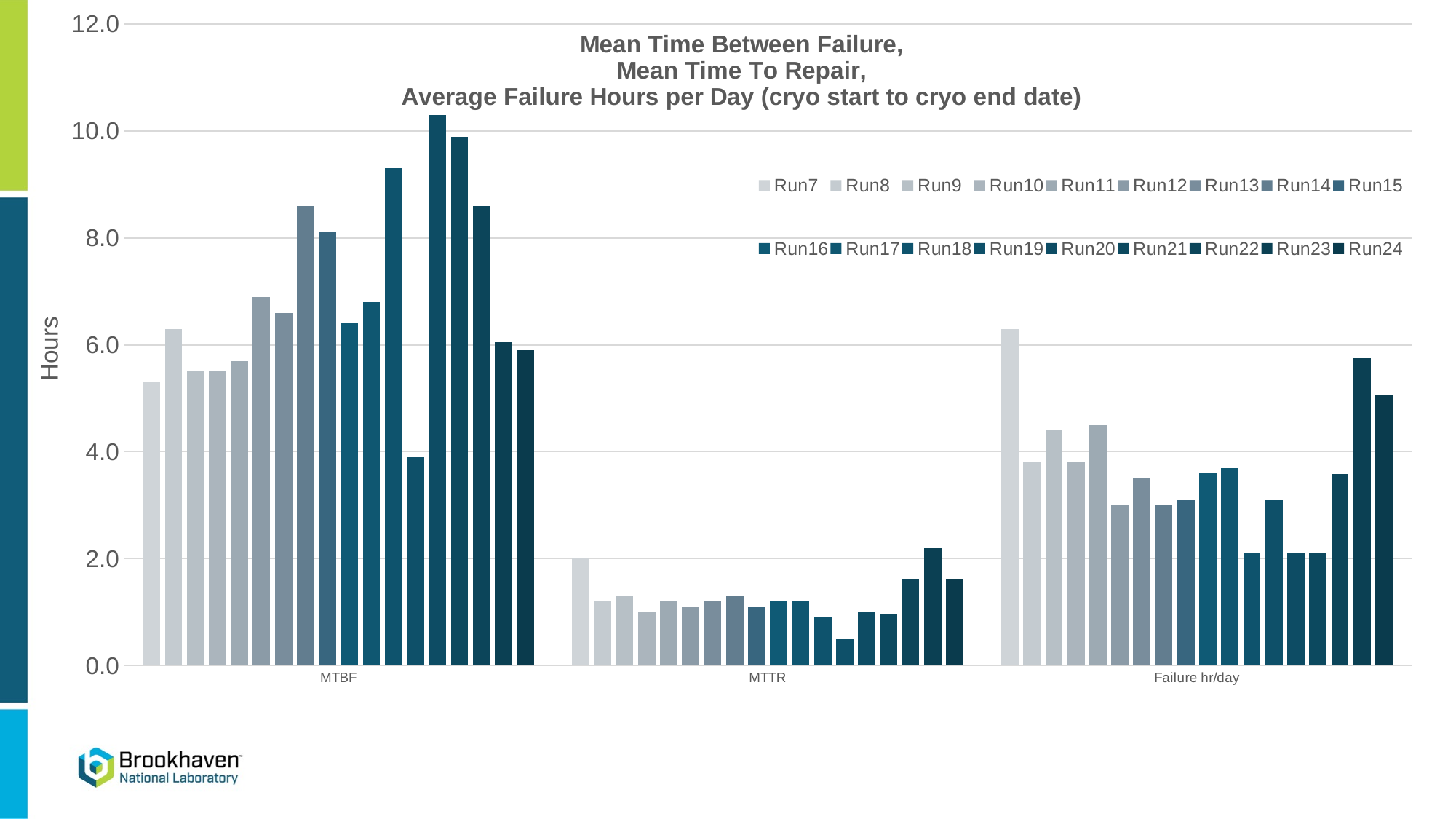
Which category contains the tallest bar in the chart: MTBF, MTTR or Failure hr/day? MTBF Which run has the lowest MTBF value? Run19 Which run has the highest MTBF value? Run20 What kind of chart is shown on the slide? Bar chart How many categories are shown on the x axis of the chart? 3 What is the label on the vertical axis of the chart? Hours How many series does the chart's legend list? 18 Is the highest MTBF bar greater or less than 10.0? greater Which run has the highest value in the Failure hr/day category? Run7 Is the MTBF value for Run7 greater or less than 6.0? less Is the Failure hr/day value for Run7 greater or less than 6.0? greater